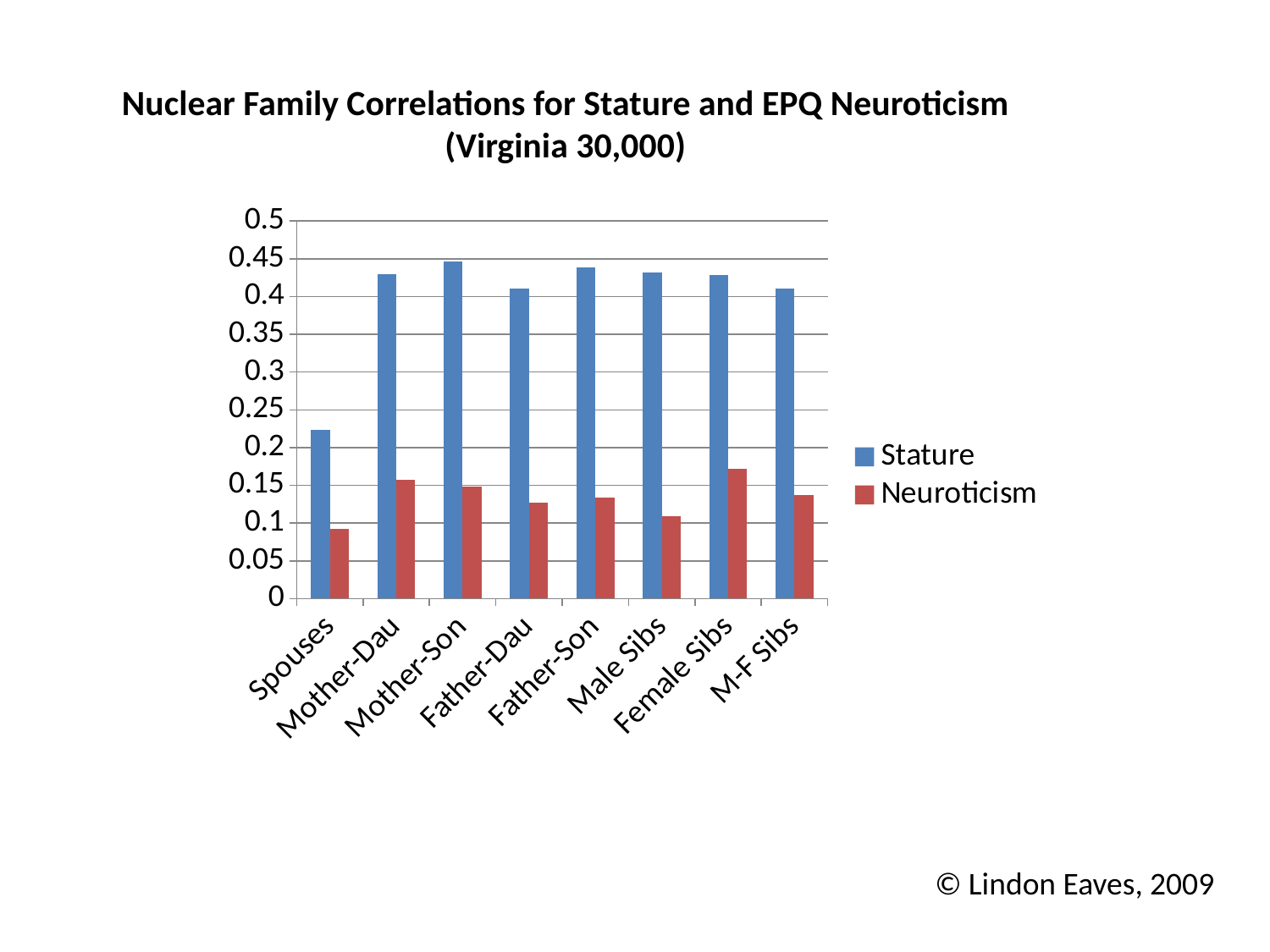
Is the Neuroticism value for Spouses greater or less than 0.1? less Which colour represents the Neuroticism series? red Which category has the lowest Stature correlation? Spouses Is the Neuroticism value for Female Sibs greater or less than 0.15? greater Is the Stature value for Spouses greater or less than 0.2? greater Which category has the lowest Neuroticism correlation? Spouses How many series does the legend list? 2 What kind of chart is shown on the slide? bar chart How many family relationship categories are shown on the x axis? 8 For Spouses, which series has the larger value, Stature or Neuroticism? Stature Which category has the highest Neuroticism correlation? Female Sibs